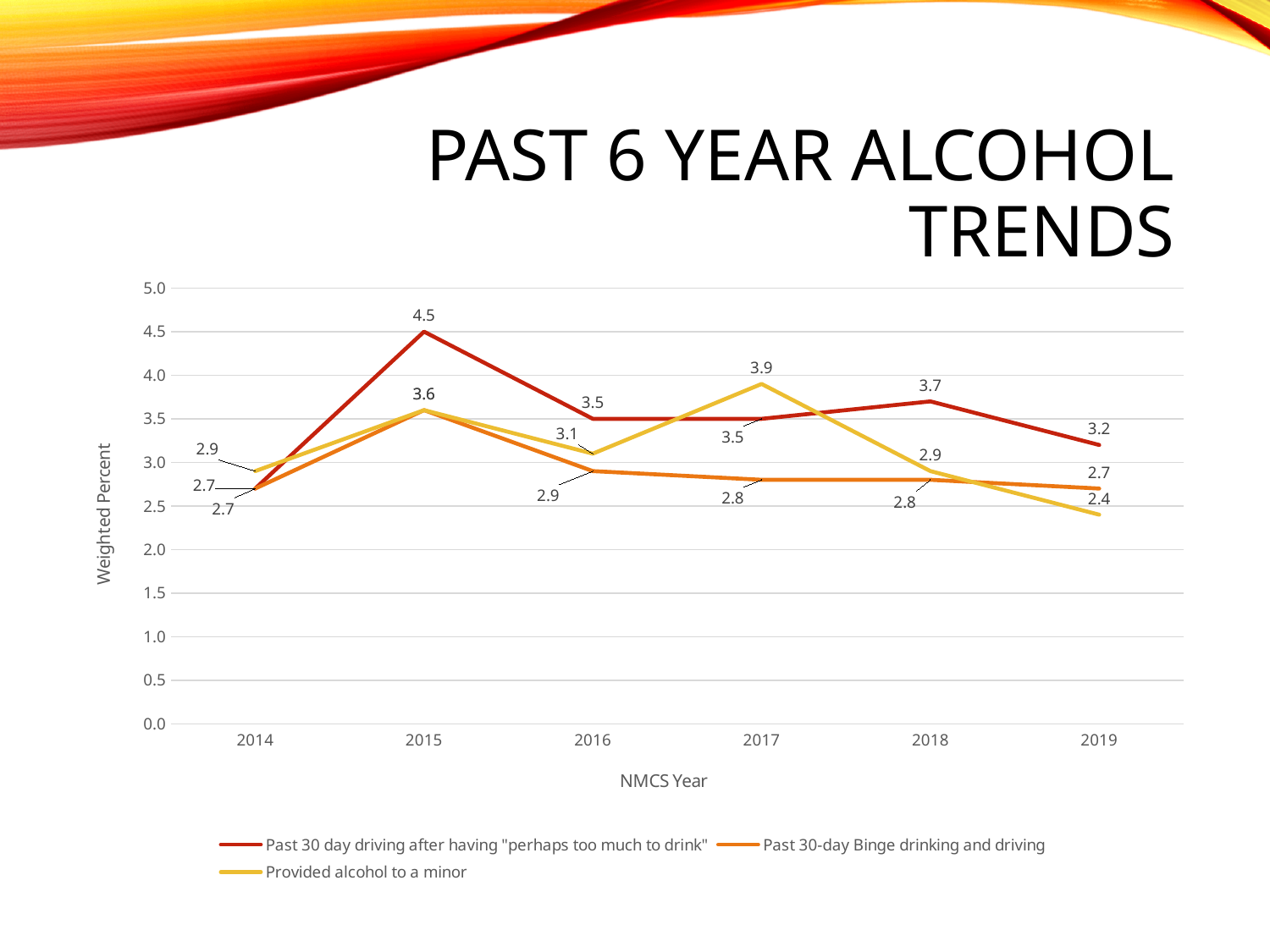
What is the value for "Past 30-day Binge drinking and driving" in 2016? 2.9 In 2017, which series has the higher value: "Provided alcohol to a minor" or "Past 30 day driving after having 'perhaps too much to drink'"? Provided alcohol to a minor In which year is "Provided alcohol to a minor" at its lowest value? 2019 How many years are shown on the x axis? 6 What is the title of the x axis? NMCS Year What kind of chart is shown on the slide? Line chart What is the value for "Provided alcohol to a minor" in 2017? 3.9 Does the value for "Past 30 day driving after having 'perhaps too much to drink'" rise or fall from 2018 to 2019? Fall In which year does "Past 30 day driving after having 'perhaps too much to drink'" reach its highest value? 2015 How many series does the legend list? 3 What is the difference between the 2015 and 2019 values for "Past 30 day driving after having 'perhaps too much to drink'"? 1.3 What is the value for "Past 30 day driving after having 'perhaps too much to drink'" in 2015? 4.5